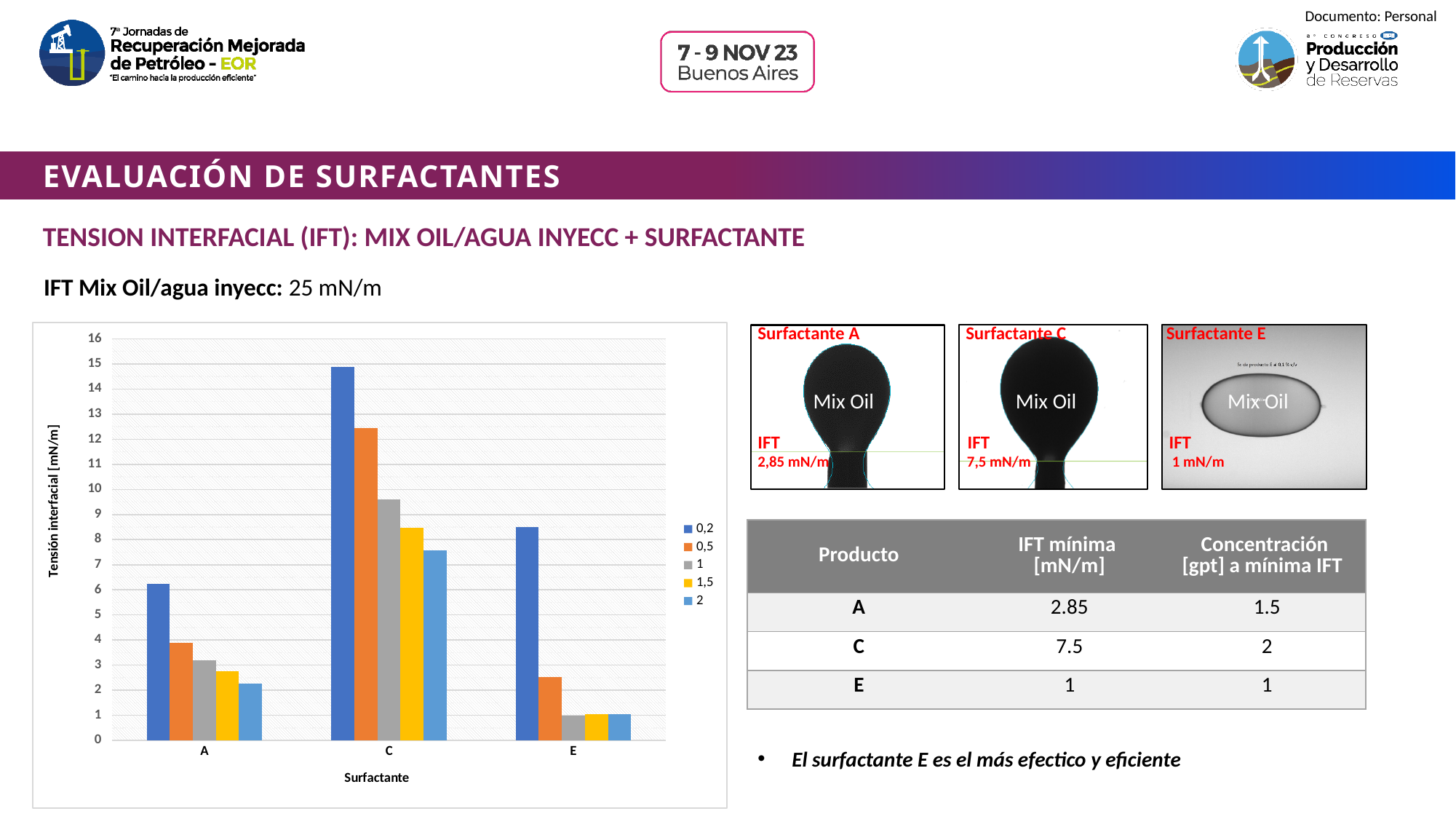
Which surfactant has the highest bar for the 0,2 series? C Is the 0,2 series value for surfactant C greater or less than 12? greater How many series does the chart legend list? 5 What is the title of the chart's y axis? Tensión interfacial [mN/m] How many surfactant categories are shown on the x axis of the chart? 3 Which surfactant has the lowest bar for the 0,2 series? A For the 0,2 series, which is larger: the value for surfactant A or surfactant E? E For surfactant C, do the bars rise or fall going from the 0,2 series to the 2 series? fall Is the 0,2 series value for surfactant A greater or less than 5? greater What kind of chart is shown on the slide? bar chart Is the 0,5 series value for surfactant E greater or less than 3? less